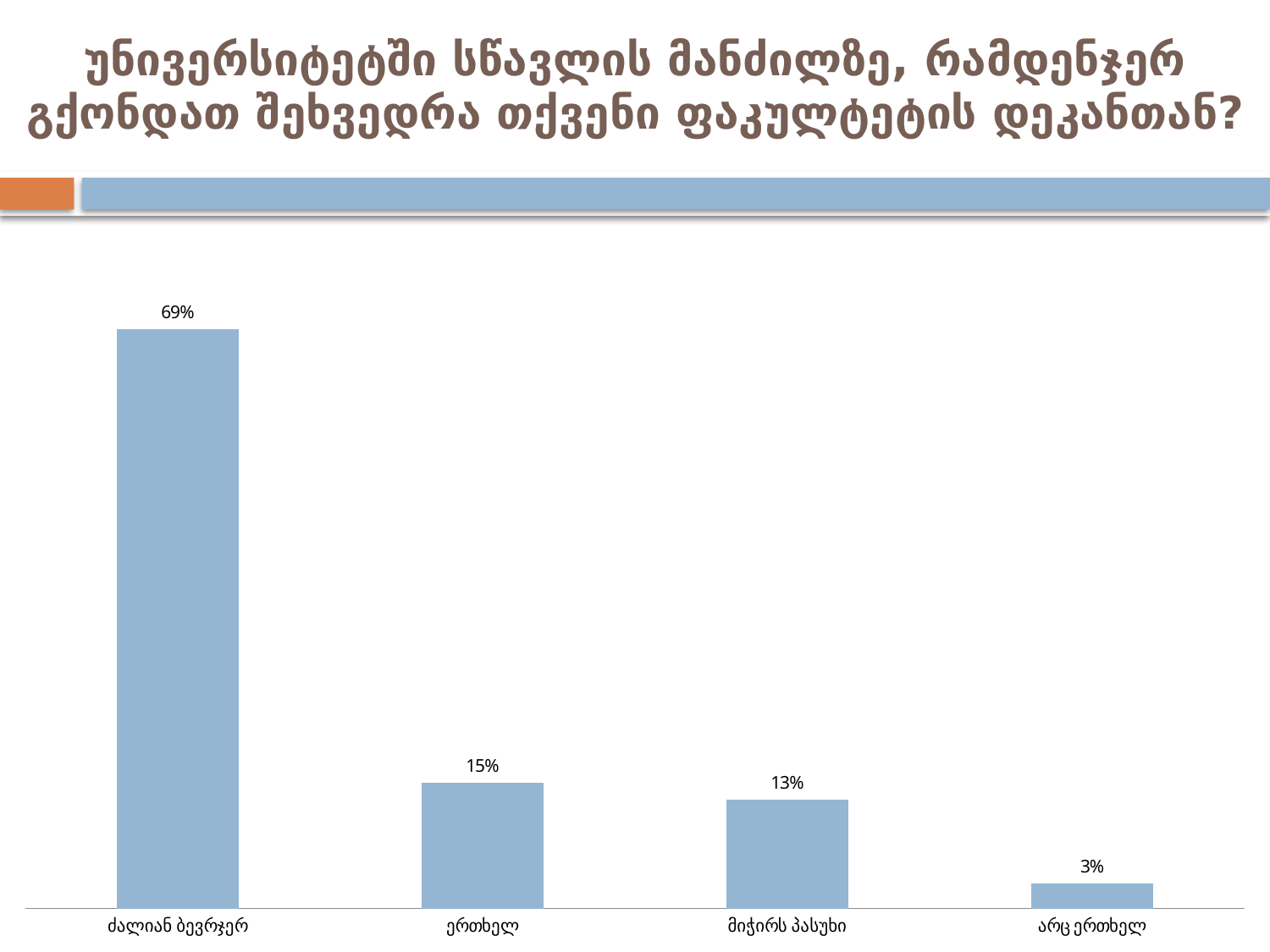
Which is larger, the value for ერთხელ or the value for მიჭირს პასუხი? ერთხელ Which category has the highest value? ძალიან ბევრჯერ Which category has the lowest value? არც ერთხელ What is the value for არც ერთხელ? 3% How many categories are shown in the chart? 4 What is the difference between the values for ერთხელ and არც ერთხელ? 12% What is the value for ერთხელ? 15% What is the difference between the values for ძალიან ბევრჯერ and ერთხელ? 54% What is the value for ძალიან ბევრჯერ? 69% What kind of chart is shown on the slide? bar chart Do the values rise or fall from left to right along the x axis? fall What is the value for მიჭირს პასუხი? 13%